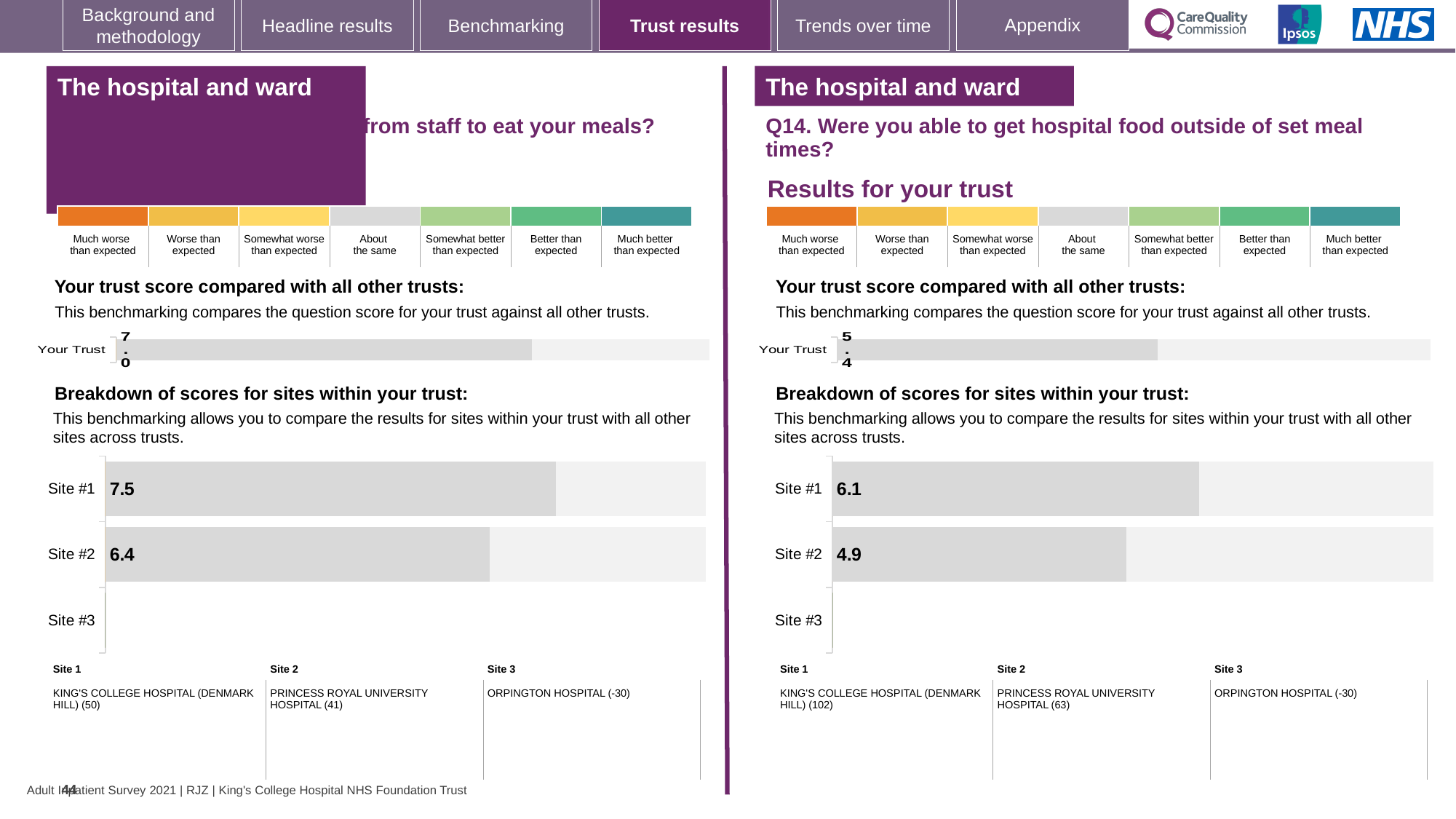
How many site categories are listed on the right-hand site breakdown chart? 3 On the right-hand chart (Q14), what is the 'Your Trust' score? 5.4 On the right-hand chart (Q14), which site has the higher score, Site #1 or Site #2? Site #1 On the right-hand chart (Q14, hospital food outside of set meal times), what is the score for Site #1? 6.1 On the left-hand chart, which site has the highest score? Site #1 On the left-hand chart (question about help from staff to eat your meals), what is the score for Site #1? 7.5 On the left-hand chart, what is the difference between the Site #1 and Site #2 scores? 1.1 On the right-hand chart (Q14), what is the score for Site #2? 4.9 On the left-hand chart, what is the 'Your Trust' score? 7.0 What type of chart is used to show the breakdown of scores for sites on the right-hand side? Bar chart On the left-hand chart, what is the score for Site #2? 6.4 On the right-hand chart (Q14), what is the difference between the Site #1 and Site #2 scores? 1.2